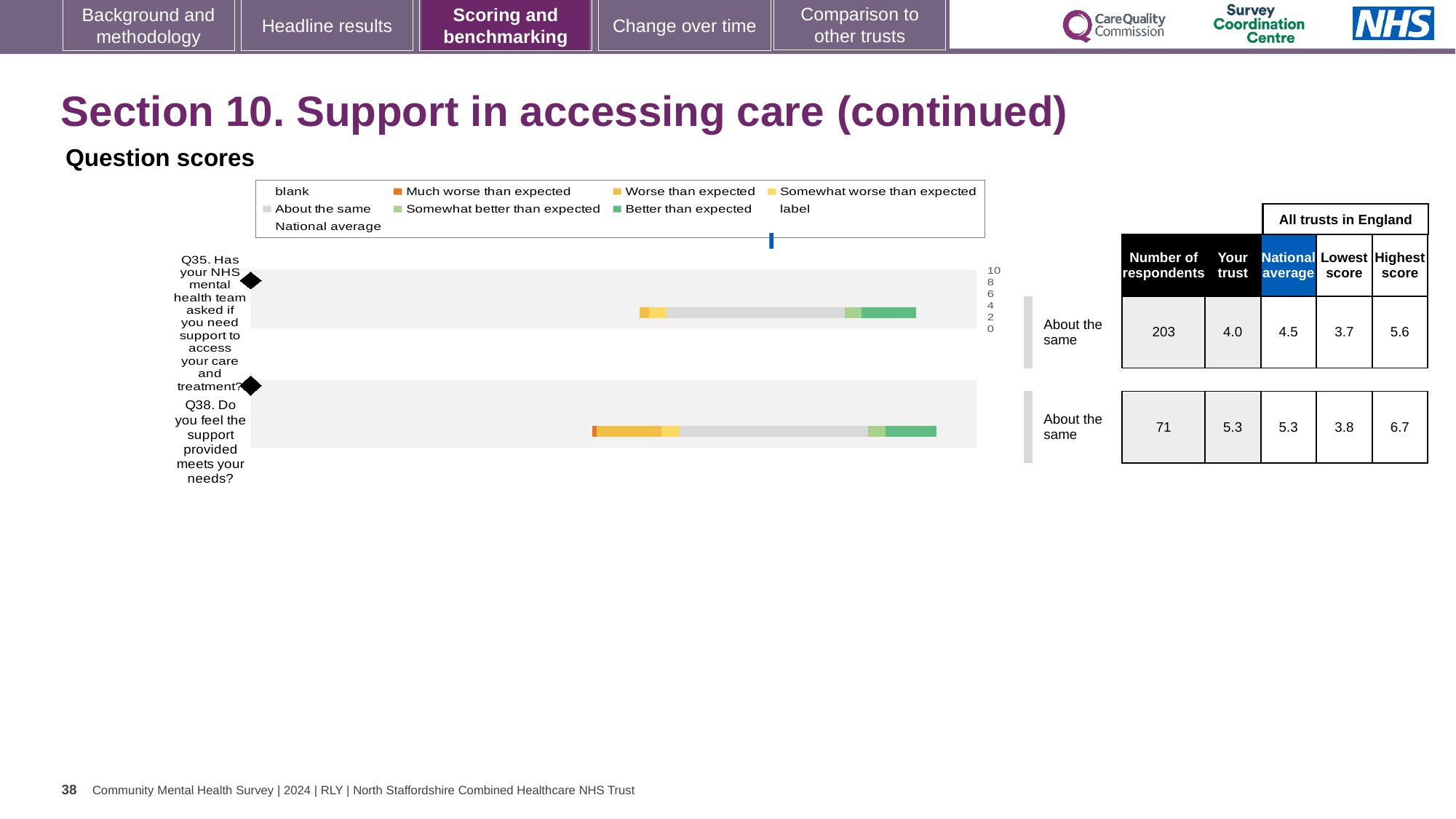
What is the 'Your trust' score for Q38 (Do you feel the support provided meets your needs)? 5.3 Which question has more respondents, Q35 or Q38? Q35 What is the difference between the highest and lowest scores for Q38? 2.9 What is the national average score for Q35? 4.5 What is the highest score among all trusts in England for Q38? 6.7 What benchmark category is the trust's score for Q35 placed in? About the same What is the 'Your trust' score for Q35 (Has your NHS mental health team asked if you need support to access your care and treatment)? 4.0 How many respondents answered Q38? 71 How many more respondents answered Q35 than Q38? 132 What is the lowest score among all trusts in England for Q35? 3.7 How many questions are plotted in the chart? 2 What kind of chart is shown on the slide? bar chart